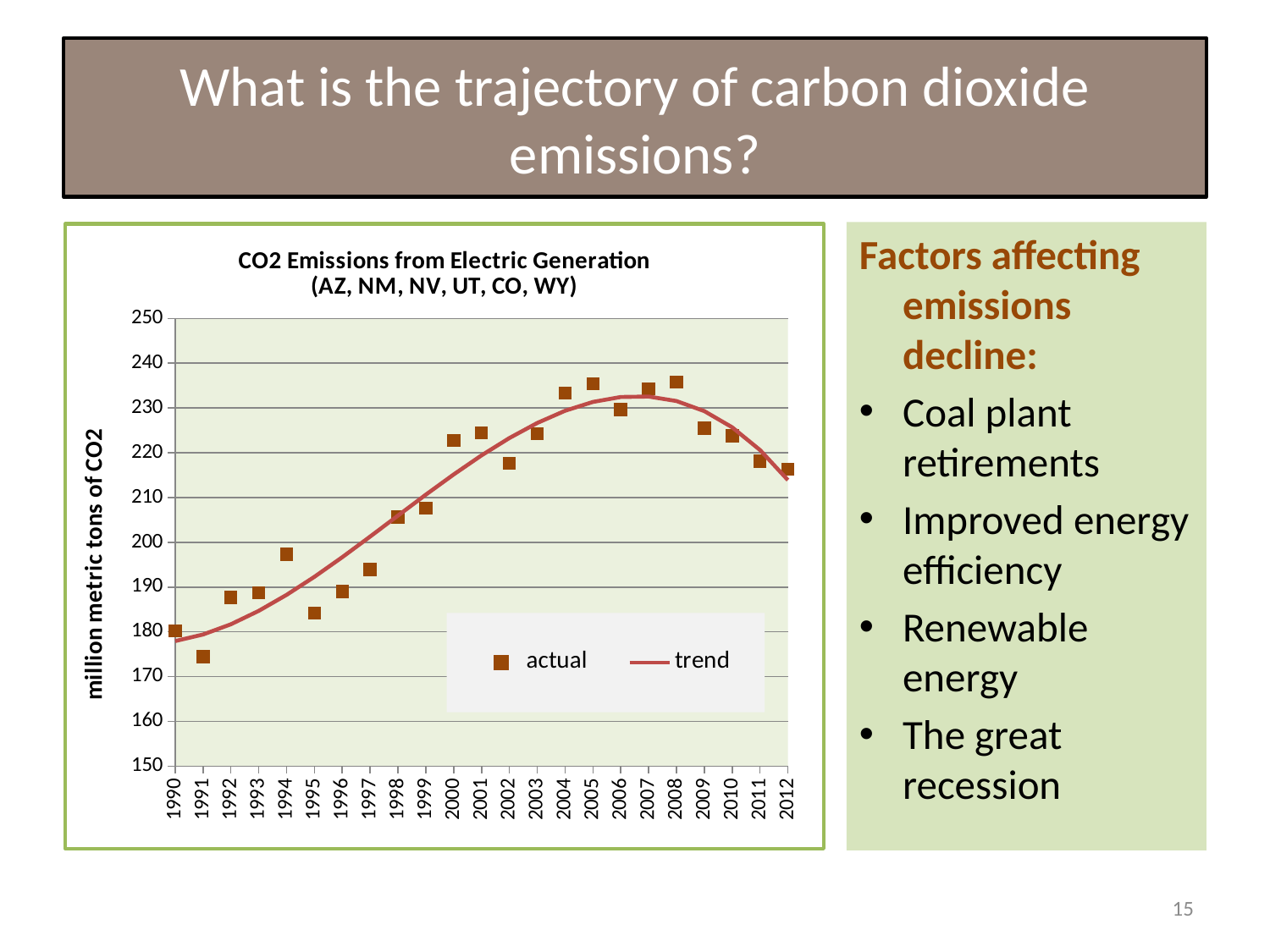
What is the label of the y axis? million metric tons of CO2 Which is larger, the actual value for 2008 or for 1991? 2008 Which year has the lowest actual value? 1991 Is the actual value for 1998 greater or less than 200? greater How many years are plotted on the x axis? 23 What is the title of the chart? CO2 Emissions from Electric Generation (AZ, NM, NV, UT, CO, WY) Do the actual values generally rise or fall from 2008 to 2012? fall Is the actual value for 2008 greater or less than 230? greater Is the actual value for 2012 greater or less than 220? less How many series does the chart legend list? 2 What kind of chart is shown on the slide? line chart